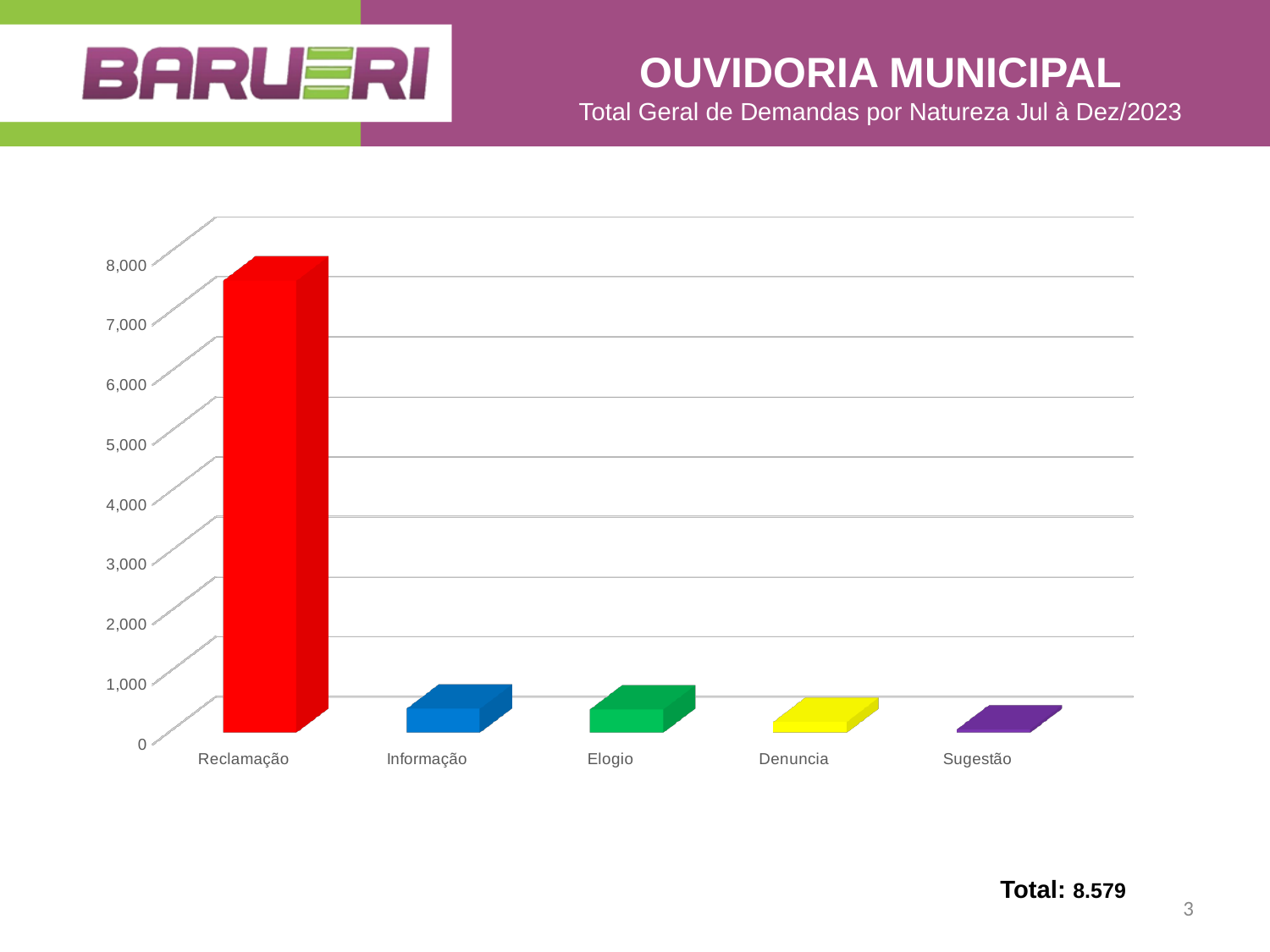
Do the values generally rise or fall from left to right along the x axis? fall Is the value for Reclamação greater or less than 7,000? greater How many categories are shown on the x axis of the chart? 5 Which category has the highest value in the chart? Reclamação What total is printed below the chart on the slide? 8.579 What kind of chart is shown on the slide? bar chart Is the value for Reclamação greater or less than 8,000? less Which is larger, the value for Informação or the value for Sugestão? Informação Which category has the lowest value in the chart? Sugestão Is the value for Elogio greater or less than 1,000? less Which is larger, the value for Reclamação or the value for Informação? Reclamação